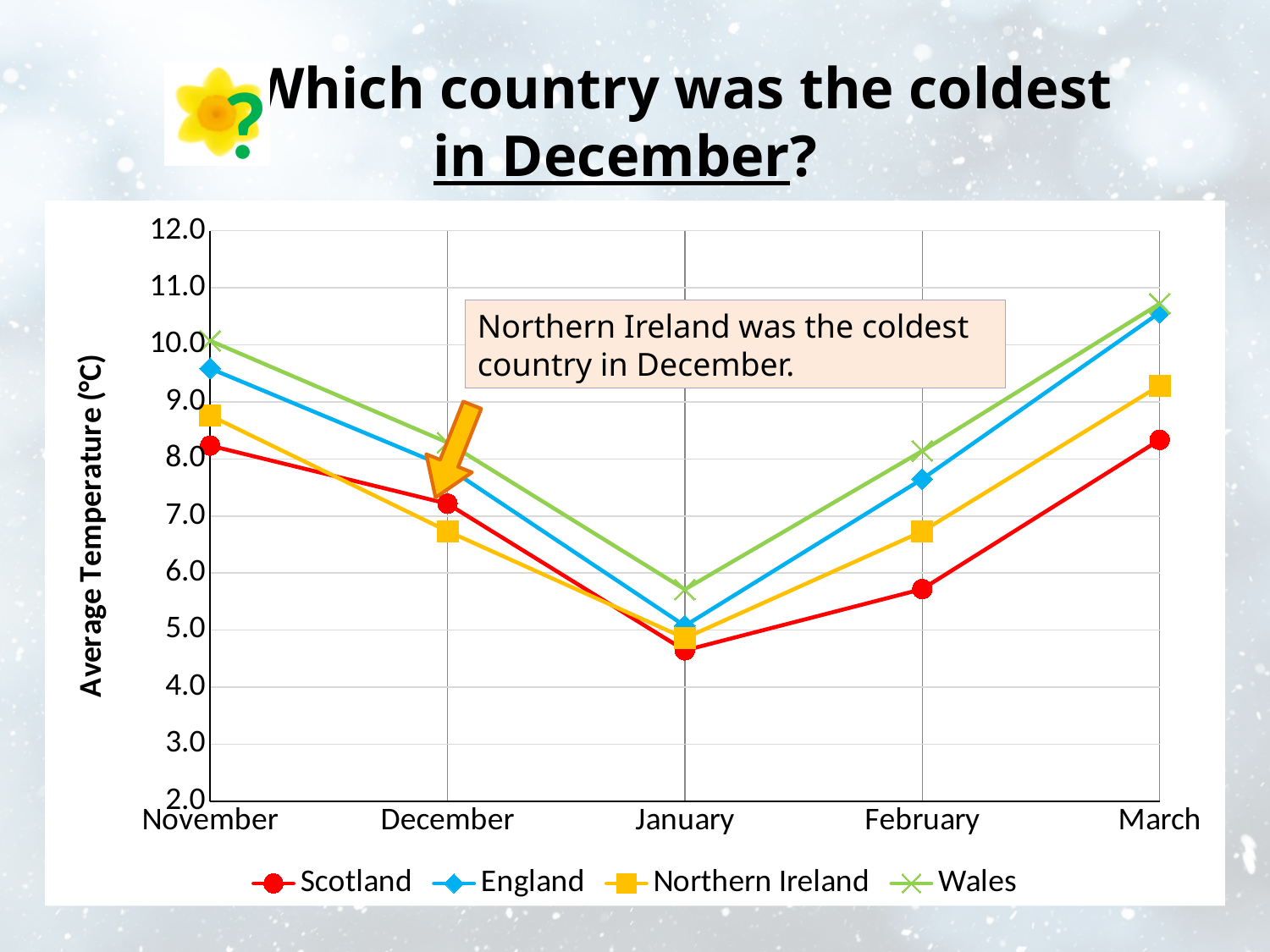
What kind of chart is shown on the slide? line chart How many months are shown along the x axis? 5 In December, which had the higher average temperature, Scotland or England? England Is the average temperature for Wales in March greater or less than 10.0? greater Is the average temperature for England in November greater or less than 9.0? greater Which country had the highest average temperature in November? Wales Does the average temperature for Scotland rise or fall from November to January? fall Which country had the lowest average temperature in December? Northern Ireland Is the average temperature for Scotland in February greater or less than 6.0? less Which country had the lowest average temperature in February? Scotland How many countries (series) does the legend list? 4 What is the title of the vertical axis? Average Temperature (°C)